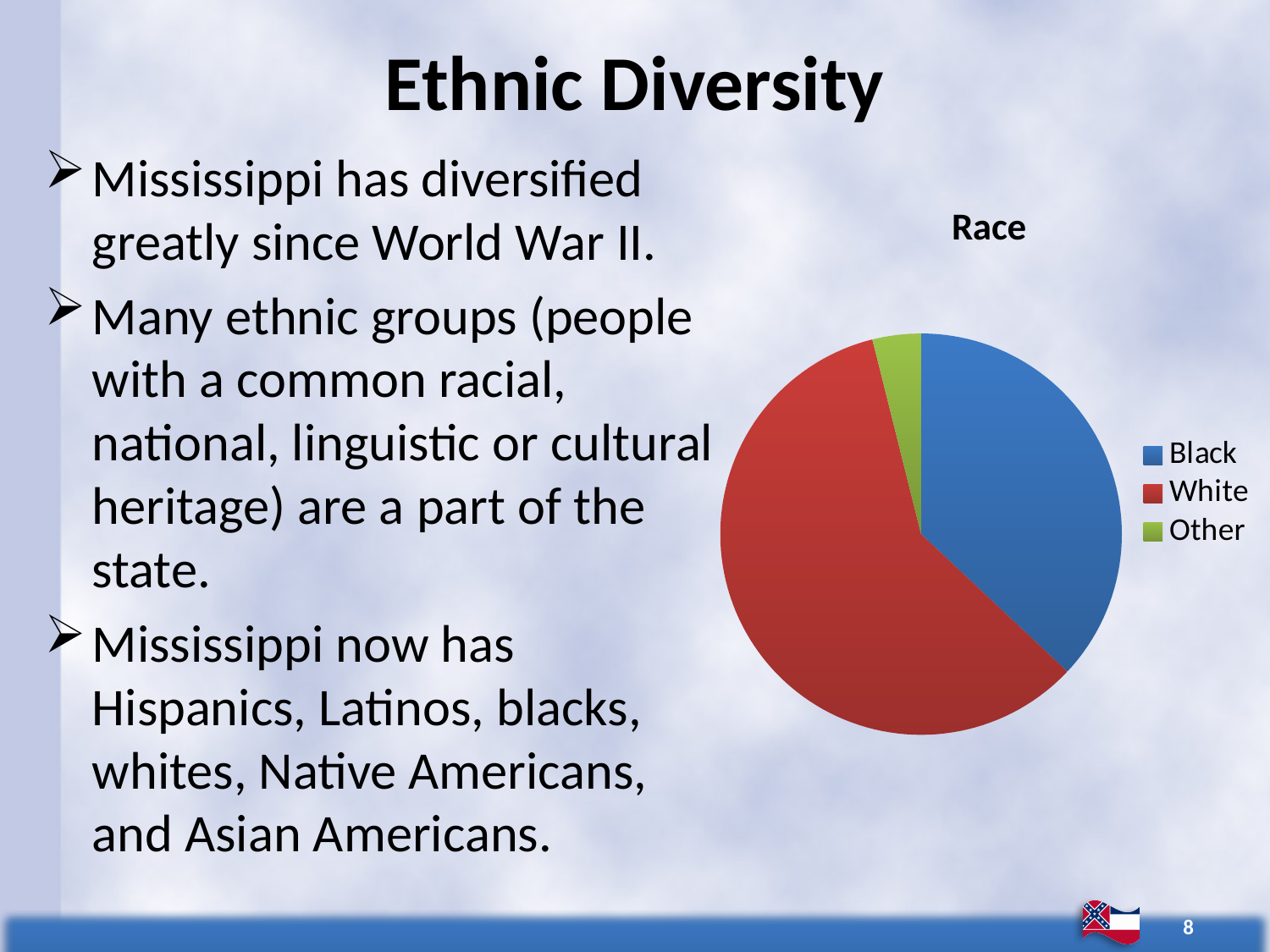
Which category has the largest slice of the pie? White Which slice is smaller, White or Other? Other What colour is the slice for Black in the pie chart? blue What kind of chart is shown on the slide? pie chart Which slice is larger, Black or Other? Black Which slice is larger, Black or White? White Which category has the smallest slice of the pie? Other How many categories does the pie chart show? 3 What is the title of the chart? Race How many entries does the chart legend list? 3